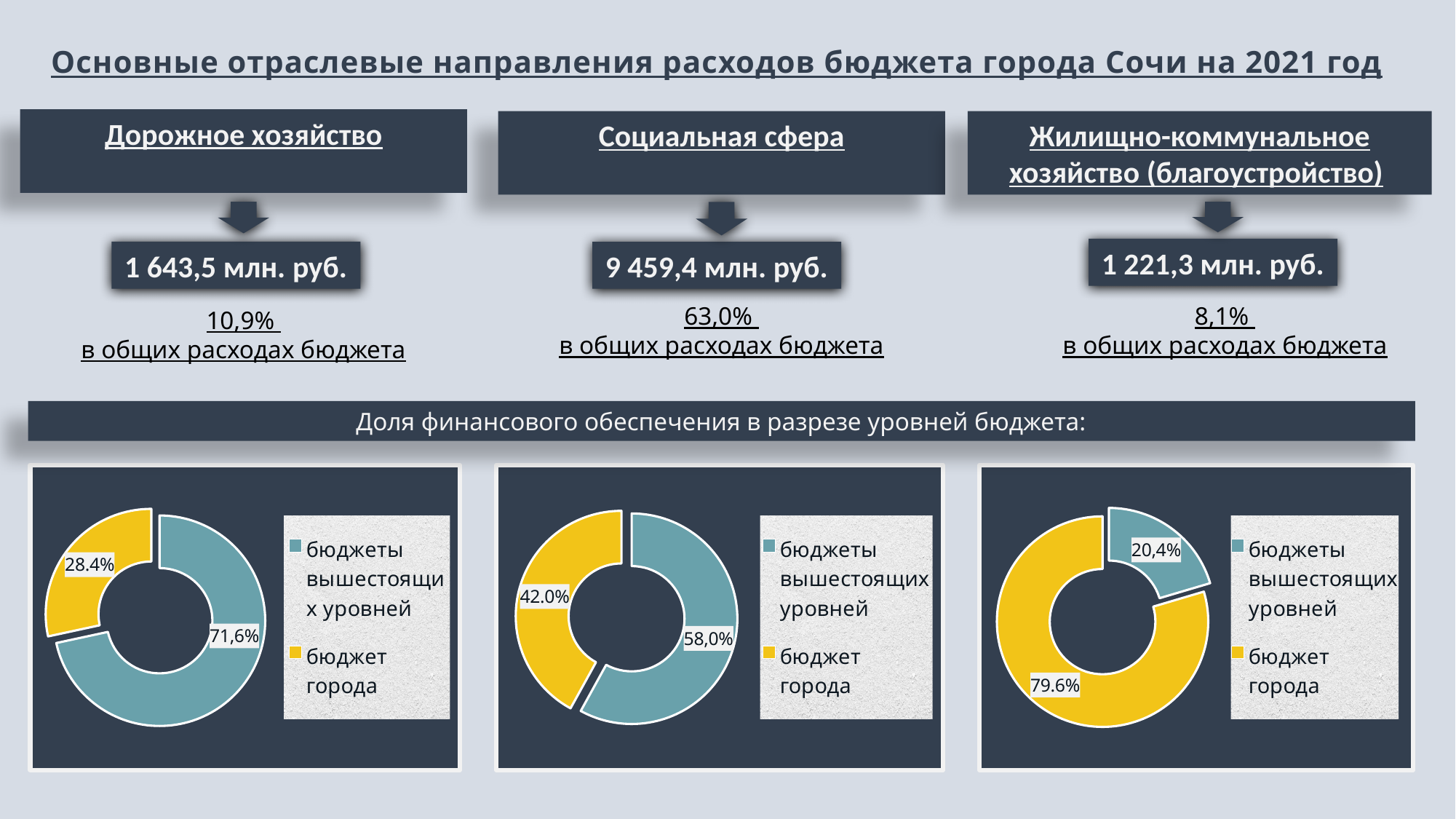
In the right doughnut chart, what share is labelled for бюджет города? 79.6% In the middle doughnut chart, what share is labelled for бюджеты вышестоящих уровней? 58,0% In the left doughnut chart, which category has the smaller share? бюджет города What type of chart is used in the three charts at the bottom of the slide? doughnut chart In the middle doughnut chart, what share is labelled for бюджет города? 42.0% In the left doughnut chart, what share is labelled for бюджет города? 28.4% In the left doughnut chart, what colour represents бюджет города? yellow In the left doughnut chart, what share is labelled for бюджеты вышестоящих уровней? 71,6% In the right doughnut chart, which category has the larger share? бюджет города In the middle doughnut chart, is the share for бюджеты вышестоящих уровней larger or smaller than the share for бюджет города? larger How many entries does the legend of the middle doughnut chart list? 2 In the right doughnut chart, what share is labelled for бюджеты вышестоящих уровней? 20,4%